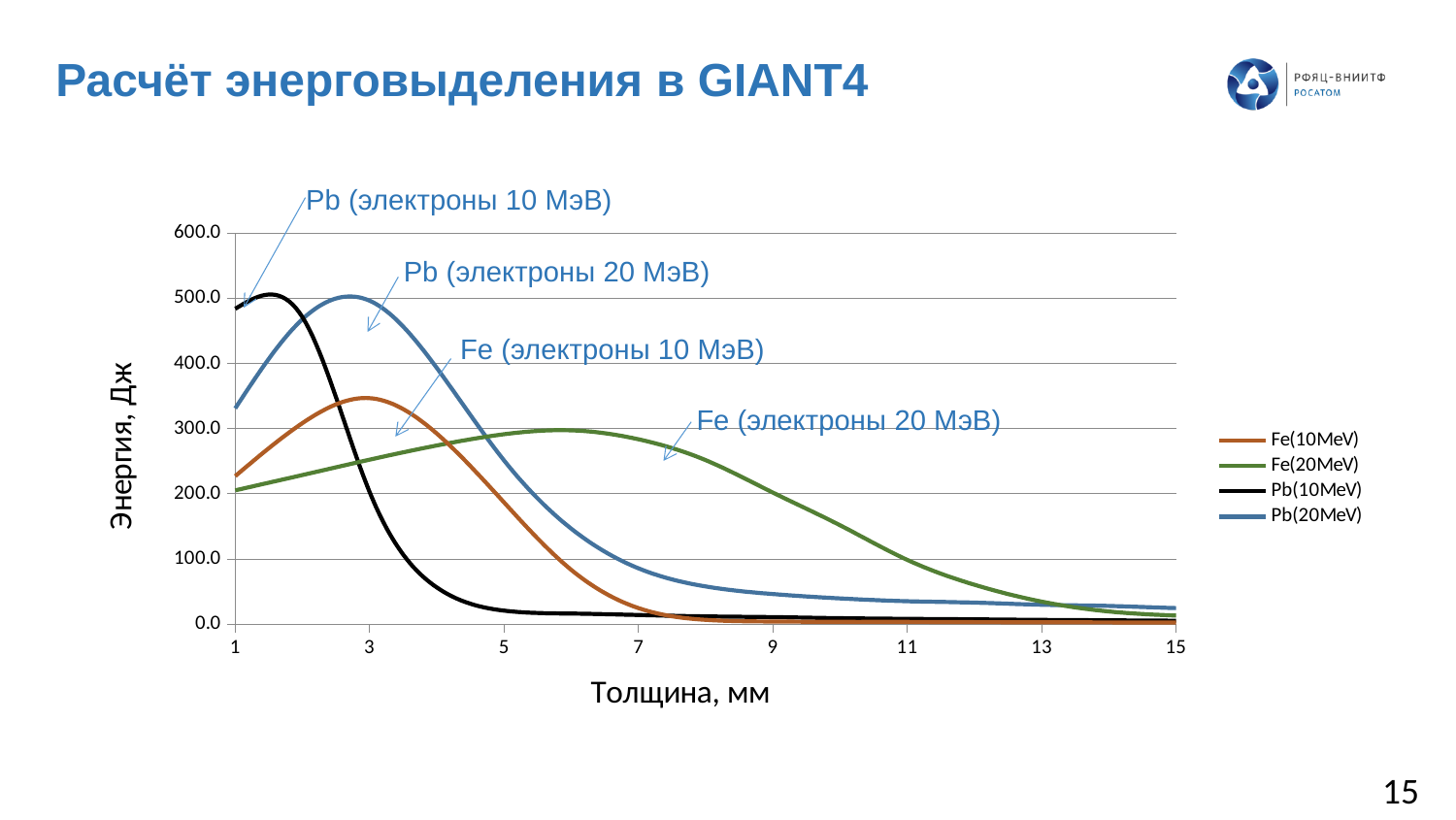
Is the value for Fe(20MeV) at thickness 1 mm greater or less than 300? less Is the value for Fe(10MeV) at thickness 3 mm greater or less than 300? greater How many series does the legend list? 4 At thickness 1 mm, which series has the larger value, Pb(20MeV) or Fe(10MeV)? Pb(20MeV) What kind of chart is shown on the slide? line chart Is the value for Pb(10MeV) at thickness 5 mm greater or less than 100? less Does the Pb(10MeV) series rise or fall between thickness 3 mm and 7 mm? fall What is the title of the slide containing the chart? Расчёт энерговыделения в GIANT4 Which series has the lowest peak value on the chart? Fe(20MeV) At thickness 9 mm, which series has the larger value, Fe(20MeV) or Pb(20MeV)? Fe(20MeV) What is the label of the x axis? Толщина, мм